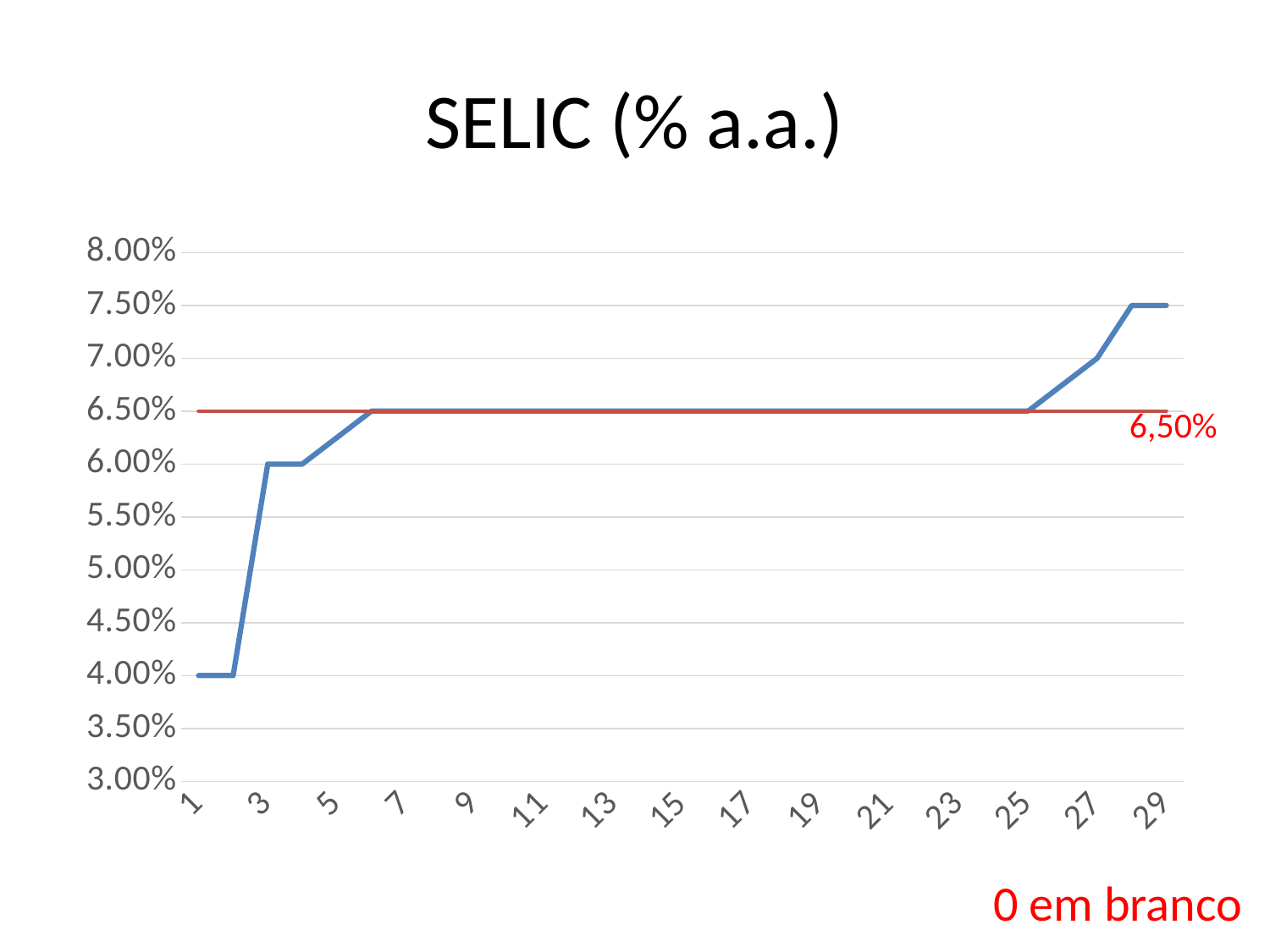
What is the SELIC value at point 15 on the x axis? 6.50% By how much does the SELIC value at point 29 exceed the value at point 1? 3.50% What is the title of the chart? SELIC (% a.a.) Does the SELIC value rise or fall overall from point 1 to point 29? rise Which has the larger SELIC value, point 3 or point 27? point 27 What value is labelled on the red horizontal line? 6,50% What is the lowest SELIC value plotted on the chart? 4.00% What is the highest SELIC value plotted on the chart? 7.50% What kind of chart is shown on the slide? line chart What is the SELIC value at point 1 on the x axis? 4.00% What is the SELIC value at point 29 on the x axis? 7.50% Is the SELIC value at point 2 greater or less than 5.00%? less